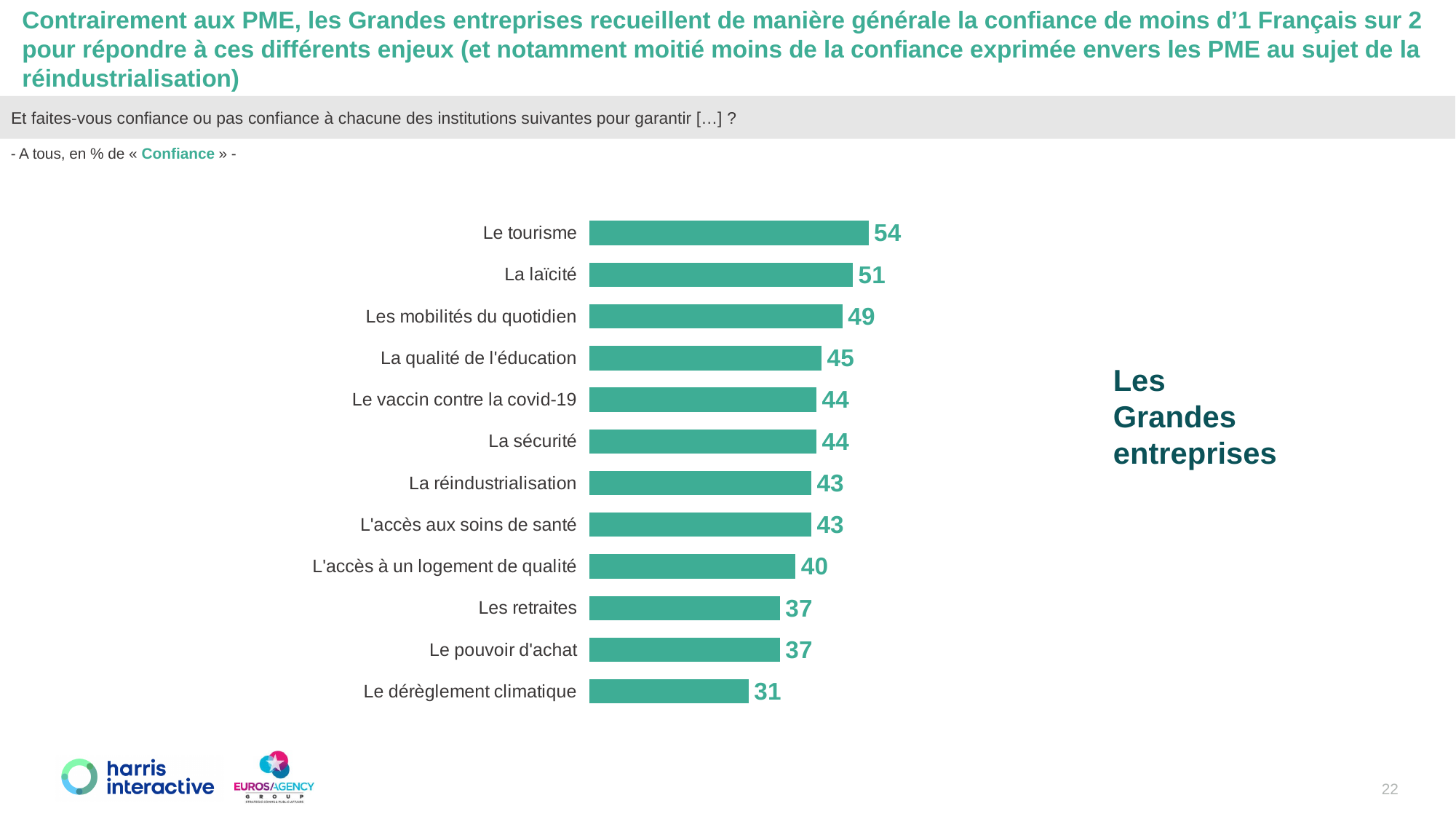
How many categories are shown in the chart? 12 What is the difference between the values for La laïcité and Les retraites? 14 What is the difference between the values for Le tourisme and Le dérèglement climatique? 23 Which category has the lowest value? Le dérèglement climatique What is the value for Le tourisme? 54 What kind of chart is shown on the slide? Bar chart What is the value for Le dérèglement climatique? 31 What is the value for L'accès à un logement de qualité? 40 Which category has the highest value? Le tourisme Which is larger, the value for Les mobilités du quotidien or the value for La qualité de l'éducation? Les mobilités du quotidien Which institution does the chart refer to, according to the label next to it? Les Grandes entreprises What is the value for La réindustrialisation? 43